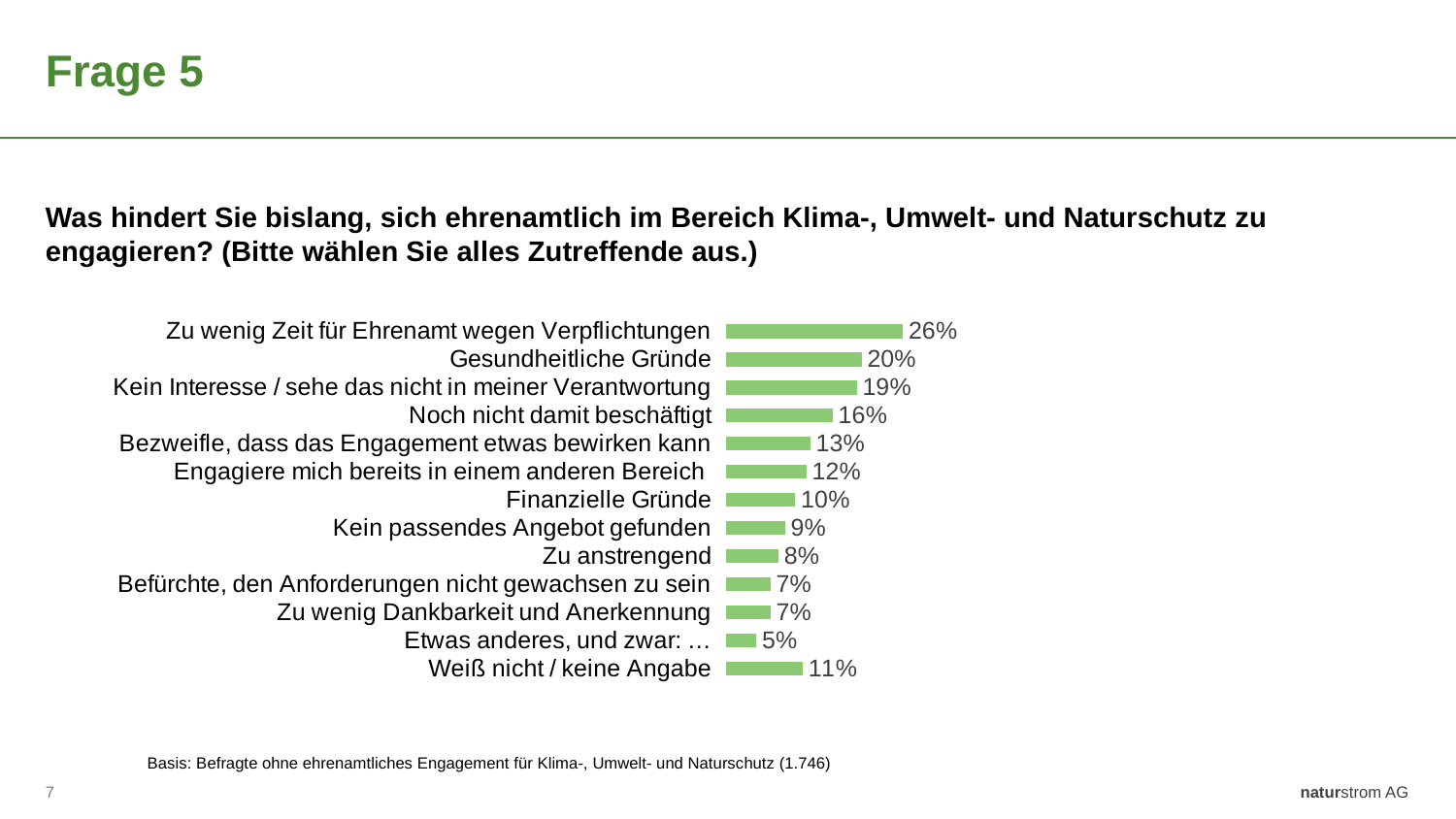
What is the value for "Weiß nicht / keine Angabe"? 11% What colour are the bars in the chart? Green Which is larger: "Noch nicht damit beschäftigt" or "Engagiere mich bereits in einem anderen Bereich"? Noch nicht damit beschäftigt Which category has the highest value? Zu wenig Zeit für Ehrenamt wegen Verpflichtungen What is the value for "Zu wenig Zeit für Ehrenamt wegen Verpflichtungen"? 26% What is the value for "Finanzielle Gründe"? 10% What is the difference between "Kein passendes Angebot gefunden" and "Zu anstrengend"? 1% What is the value for "Gesundheitliche Gründe"? 20% How many categories are shown in the chart? 13 What kind of chart is shown on the slide? Bar chart What is the difference between "Zu wenig Zeit für Ehrenamt wegen Verpflichtungen" and "Gesundheitliche Gründe"? 6% Which category has the lowest value? Etwas anderes, und zwar: …